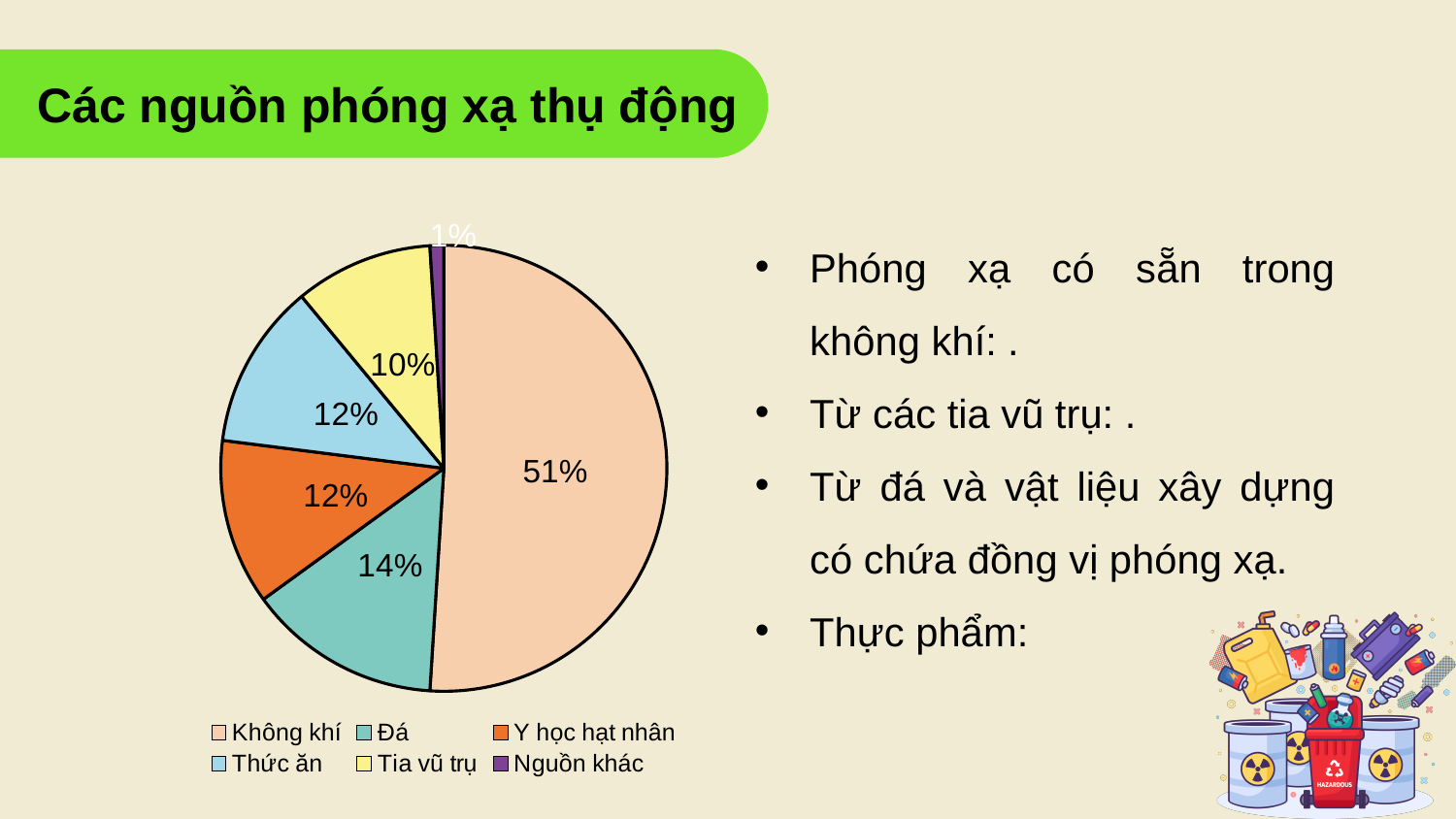
What type of chart is shown on the slide? Pie chart How many categories does the legend list? 6 Which category has the largest slice of the pie? Không khí Which is larger, the value for Đá or the value for Tia vũ trụ? Đá What is the value shown for Tia vũ trụ? 10% What is the value shown for Đá? 14% What is the value shown for Nguồn khác? 1% Which category has the smallest slice of the pie? Nguồn khác What is the difference between the values for Không khí and Đá? 37% What is the value shown for Y học hạt nhân? 12% What colour is the slice for Nguồn khác? Purple What share of the pie does Không khí represent? 51%